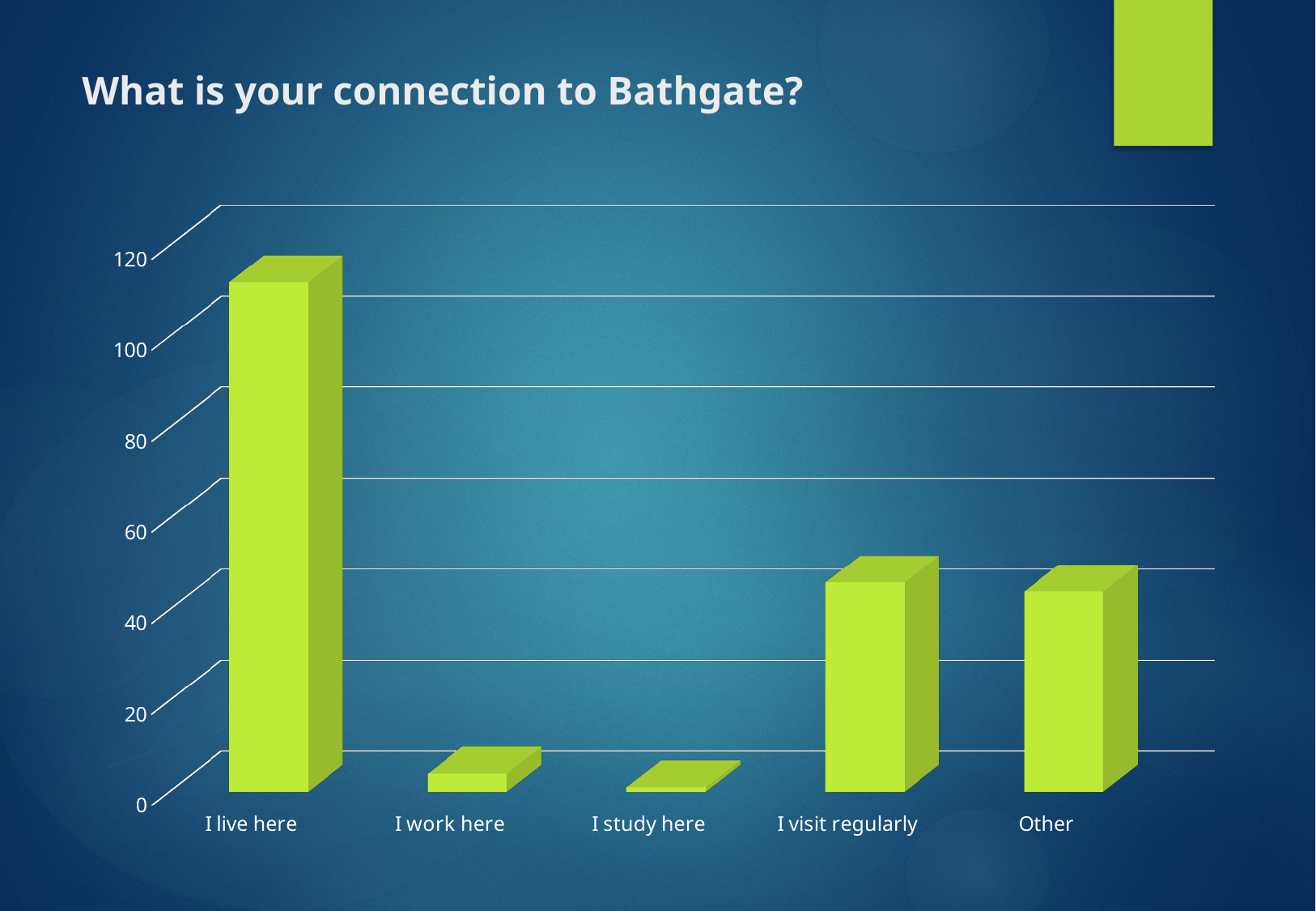
What kind of chart is shown on the slide? bar chart Is the value for Other greater or less than 20? greater Which is larger, the value for I visit regularly or the value for I study here? I visit regularly What is the title of the chart? What is your connection to Bathgate? Which is larger, the value for I live here or the value for Other? I live here Which category has the highest value? I live here Is the value for I visit regularly greater or less than 60? less Is the value for I work here greater or less than 20? less What colour are the bars in the chart? green Which category has the lowest value? I study here How many categories are shown on the x axis of the chart? 5